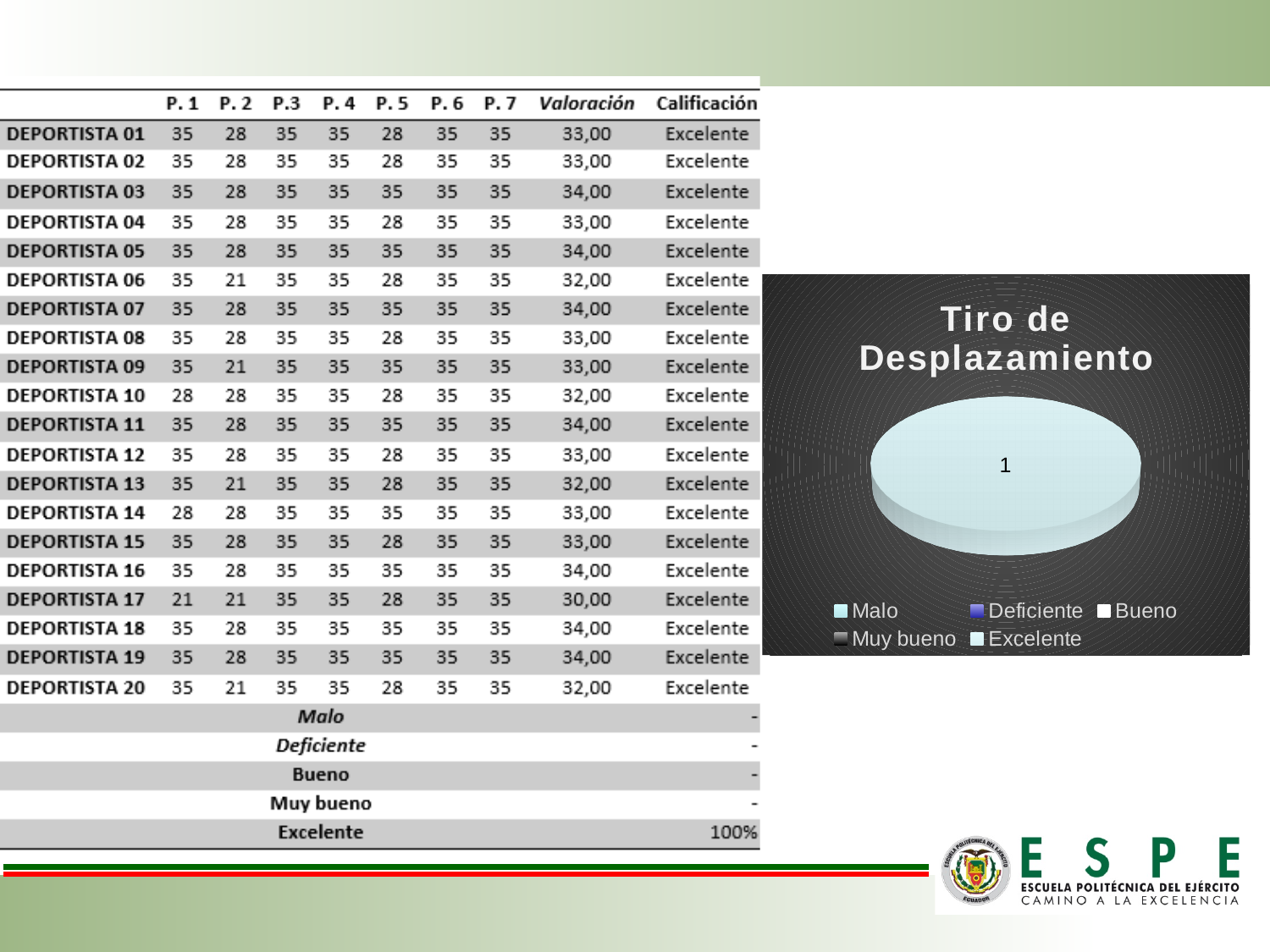
What kind of chart is shown on the slide? pie chart How many slices are visible in the pie chart? 1 What data label is printed on the slice of the pie chart? 1 What share of the pie chart does the Excelente slice occupy? 100% Which legend entry is listed first in the pie chart's legend? Malo What is the title of the pie chart? Tiro de Desplazamiento Which legend category does the single slice of the pie chart belong to? Excelente How many entries does the legend of the pie chart list? 5